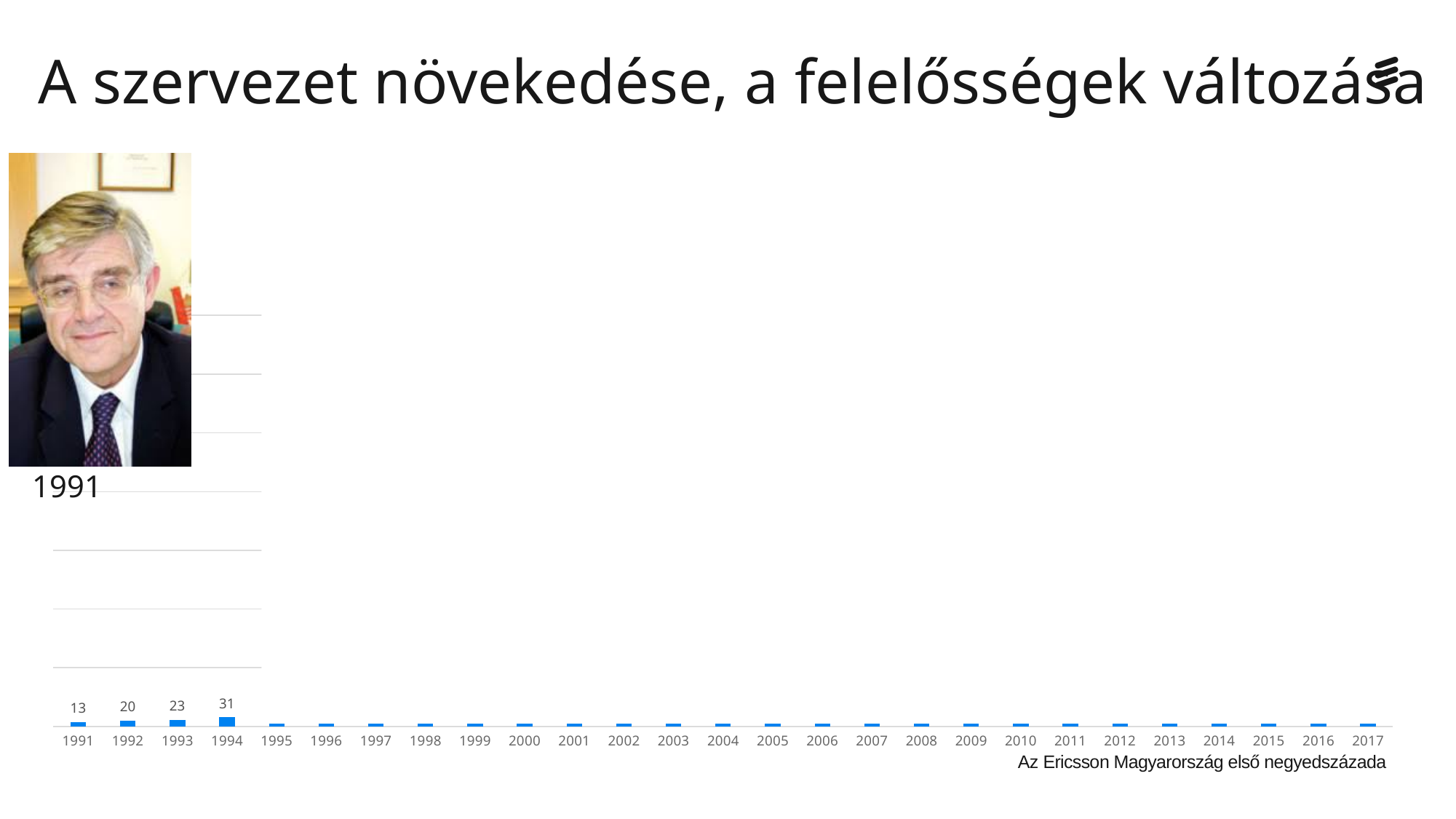
Do the labelled values rise or fall from 1991 to 1994? rise Among the bars with printed data labels, which year has the highest value? 1994 What is the value shown for 1992 in the bar chart? 20 Among the bars with printed data labels, which year has the lowest value? 1991 What is the value shown for 1993 in the bar chart? 23 What kind of chart is shown on the slide? bar chart What is the value shown for 1991 in the bar chart? 13 What is the value shown for 1994 in the bar chart? 31 Which is larger, the value for 1992 or the value for 1994? 1994 What is the difference between the values for 1993 and 1992? 3 What is the difference between the values for 1994 and 1991? 18 How many years are shown on the x axis of the chart? 27